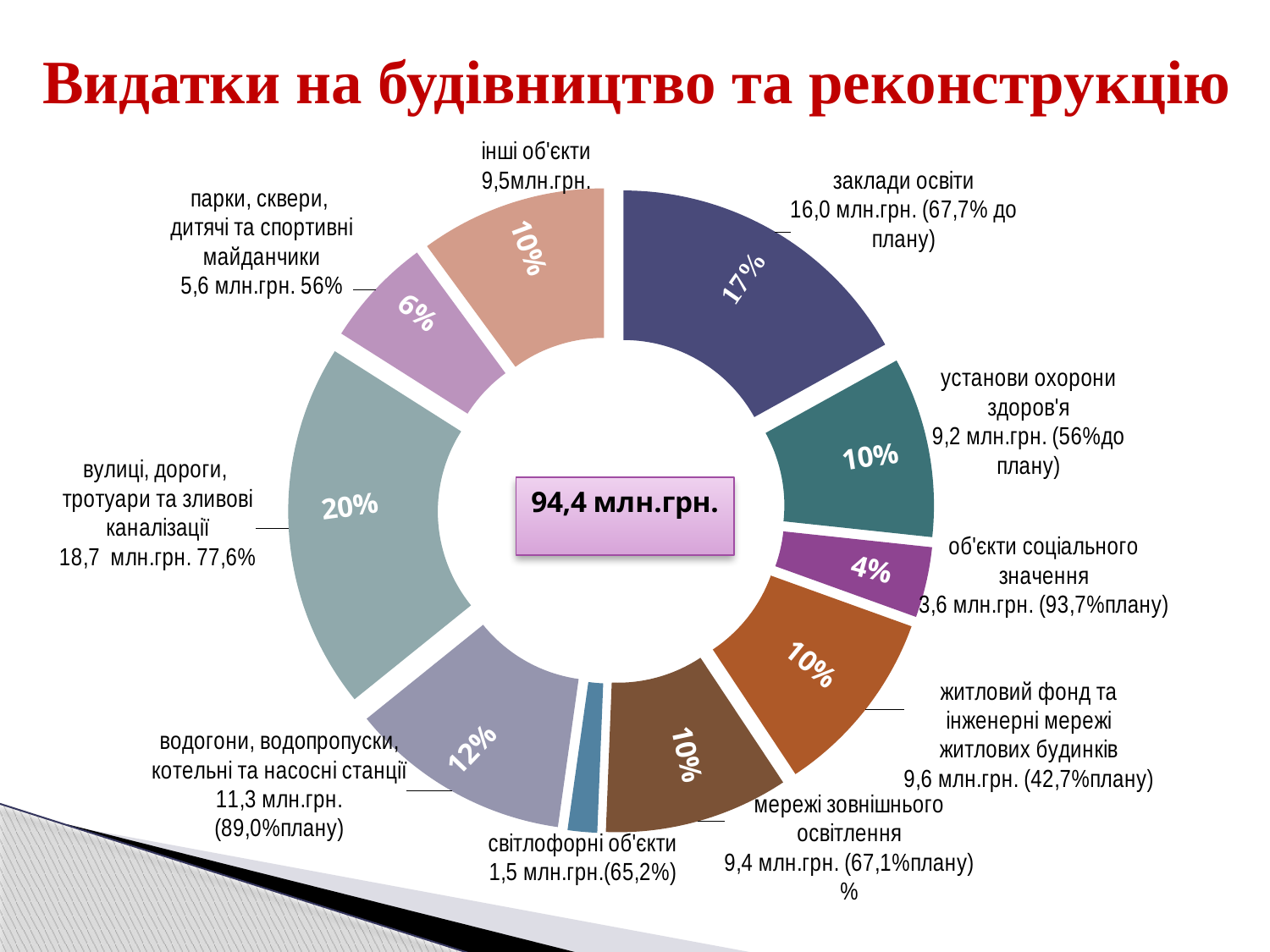
What share of the chart does 'заклади освіти' represent? 17% Which has the larger amount: 'заклади освіти' or 'установи охорони здоров'я'? заклади освіти What is the amount for 'водогони, водопропуски, котельні та насосні станції'? 11,3 млн.грн. Which category has the largest share of the chart? вулиці, дороги, тротуари та зливові каналізації Which category has the smallest amount? світлофорні об'єкти What is the difference in amount between 'вулиці, дороги, тротуари та зливові каналізації' (18,7 млн.грн.) and 'заклади освіти' (16,0 млн.грн.)? 2,7 млн.грн. How many categories (slices) does the chart show? 10 What percentage of plan is shown for 'житловий фонд та інженерні мережі житлових будинків'? 42,7% What is the amount for 'об'єкти соціального значення'? 3,6 млн.грн. What share of the chart does 'вулиці, дороги, тротуари та зливові каналізації' represent? 20% What kind of chart is shown on the slide? Doughnut (pie) chart What total amount is shown in the centre of the chart? 94,4 млн.грн.